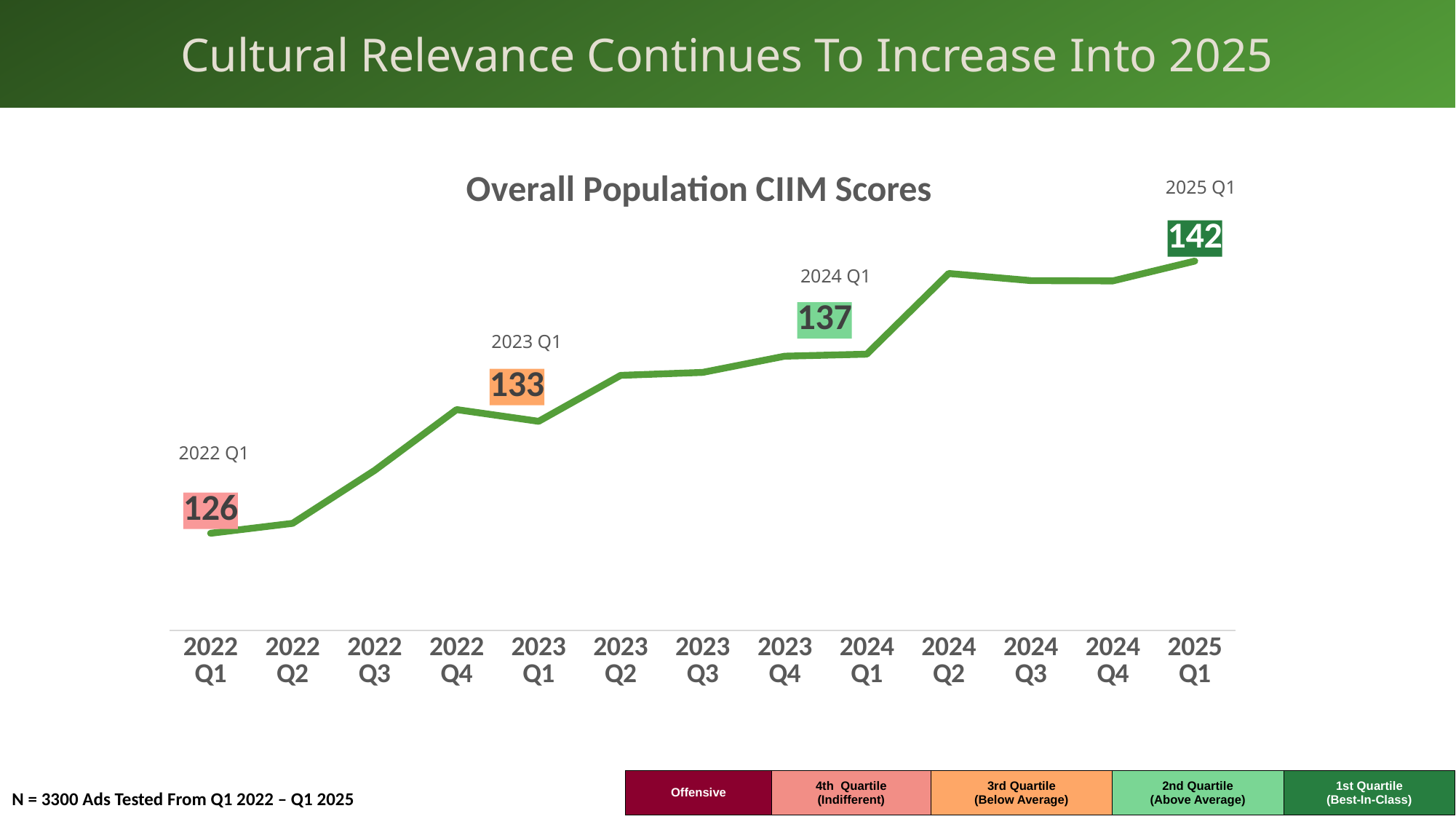
Which has the higher CIIM score, 2023 Q1 or 2024 Q1? 2024 Q1 By how much did the CIIM score increase from 2022 Q1 to 2025 Q1? 16 Do the CIIM scores generally rise or fall from 2022 Q1 to 2025 Q1? Rise Which quarter has the highest CIIM score on the chart? 2025 Q1 What kind of chart is used to show the Overall Population CIIM Scores? Line chart How many quarters are plotted on the x axis of the chart? 13 What is the Overall Population CIIM Score for 2022 Q1? 126 What is the Overall Population CIIM Score for 2023 Q1? 133 What is the Overall Population CIIM Score for 2024 Q1? 137 What is the Overall Population CIIM Score for 2025 Q1? 142 Which quarter has the lowest CIIM score on the chart? 2022 Q1 What is the difference between the CIIM scores for 2024 Q1 and 2023 Q1? 4